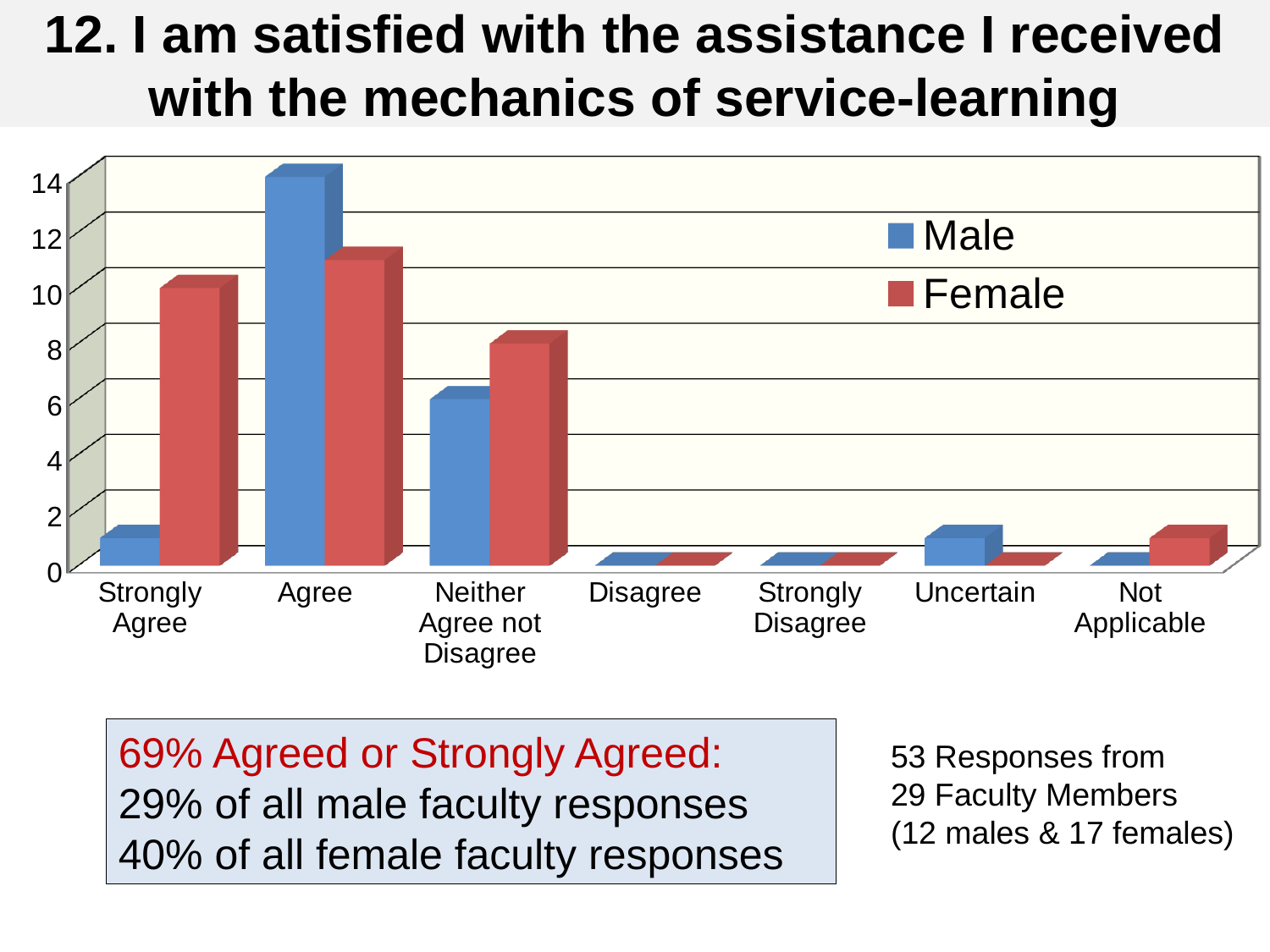
Is the Male value for Agree greater or less than 12? greater For Strongly Agree, which is larger, the Male value or the Female value? Female How many series does the legend list? 2 Is the Female value for Strongly Agree greater or less than 8? greater Which category has the highest Female value? Agree Which colour represents the Female series in the legend? red For Agree, which is larger, the Male value or the Female value? Male Which category has the highest Male value? Agree Is the Male value for Strongly Agree greater or less than 2? less What kind of chart is shown on the slide? bar chart How many response categories are shown on the x axis? 7 For Neither Agree not Disagree, which is larger, the Male value or the Female value? Female